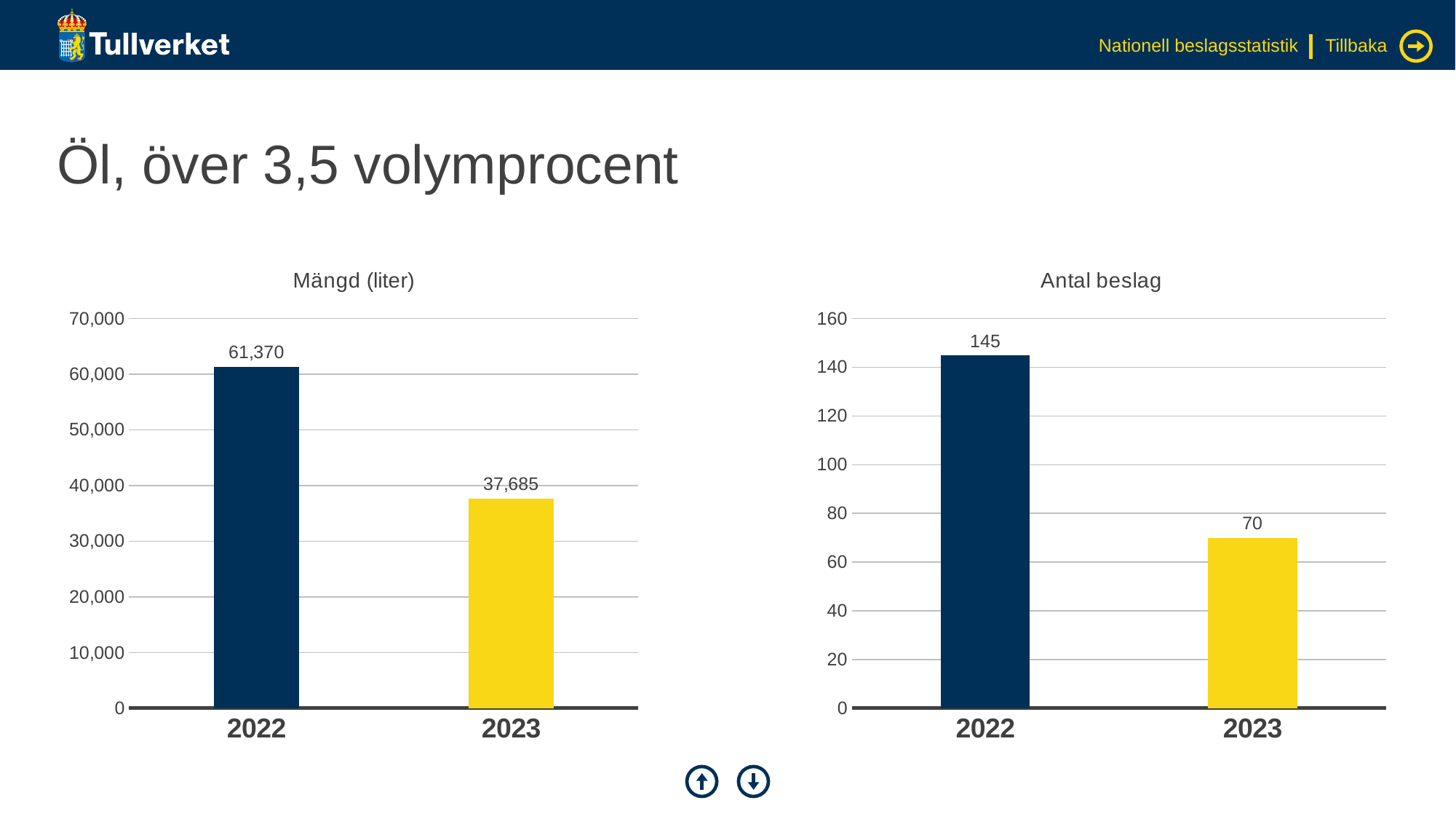
What kind of chart is the 'Antal beslag' chart? bar chart In the 'Mängd (liter)' chart, do the values rise or fall from 2022 to 2023? fall In the 'Antal beslag' chart, which year has the lowest value? 2023 In the 'Antal beslag' chart, what is the value for 2023? 70 In the 'Mängd (liter)' chart, what is the value for 2023? 37,685 How many categories are shown on the x axis of the 'Mängd (liter)' chart? 2 In the 'Mängd (liter)' chart, which year has the highest value? 2022 In the 'Antal beslag' chart, is the value for 2023 greater or less than 80? less In the 'Mängd (liter)' chart, what is the value for 2022? 61,370 In the 'Mängd (liter)' chart, what is the difference between the 2022 and 2023 values? 23,685 In the 'Antal beslag' chart, what is the value for 2022? 145 In the 'Antal beslag' chart, what is the difference between the 2022 and 2023 values? 75